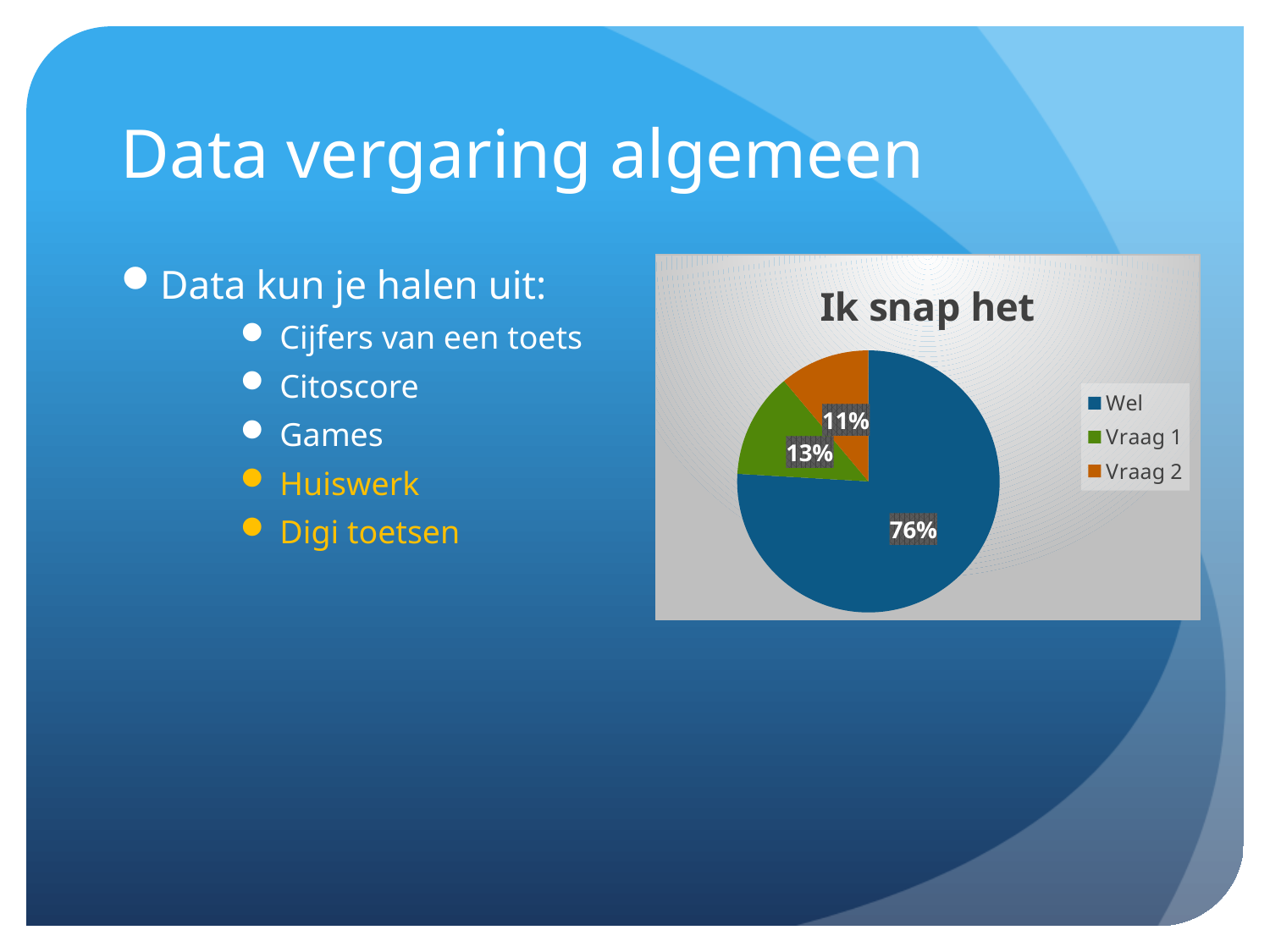
How many entries does the legend list? 3 What percentage of the pie does the 'Wel' slice represent? 76% Which slice of the pie is the largest? Wel What percentage of the pie does the 'Vraag 2' slice represent? 11% Which is larger, the 'Vraag 1' slice or the 'Vraag 2' slice? Vraag 1 What is the difference in percentage points between the 'Wel' slice and the 'Vraag 1' slice? 63 What kind of chart is shown on the slide? pie chart What percentage of the pie does the 'Vraag 1' slice represent? 13% What is the title of the chart? Ik snap het How many slices does the pie chart have? 3 What colour is the 'Wel' slice in the pie chart? blue Which slice of the pie is the smallest? Vraag 2